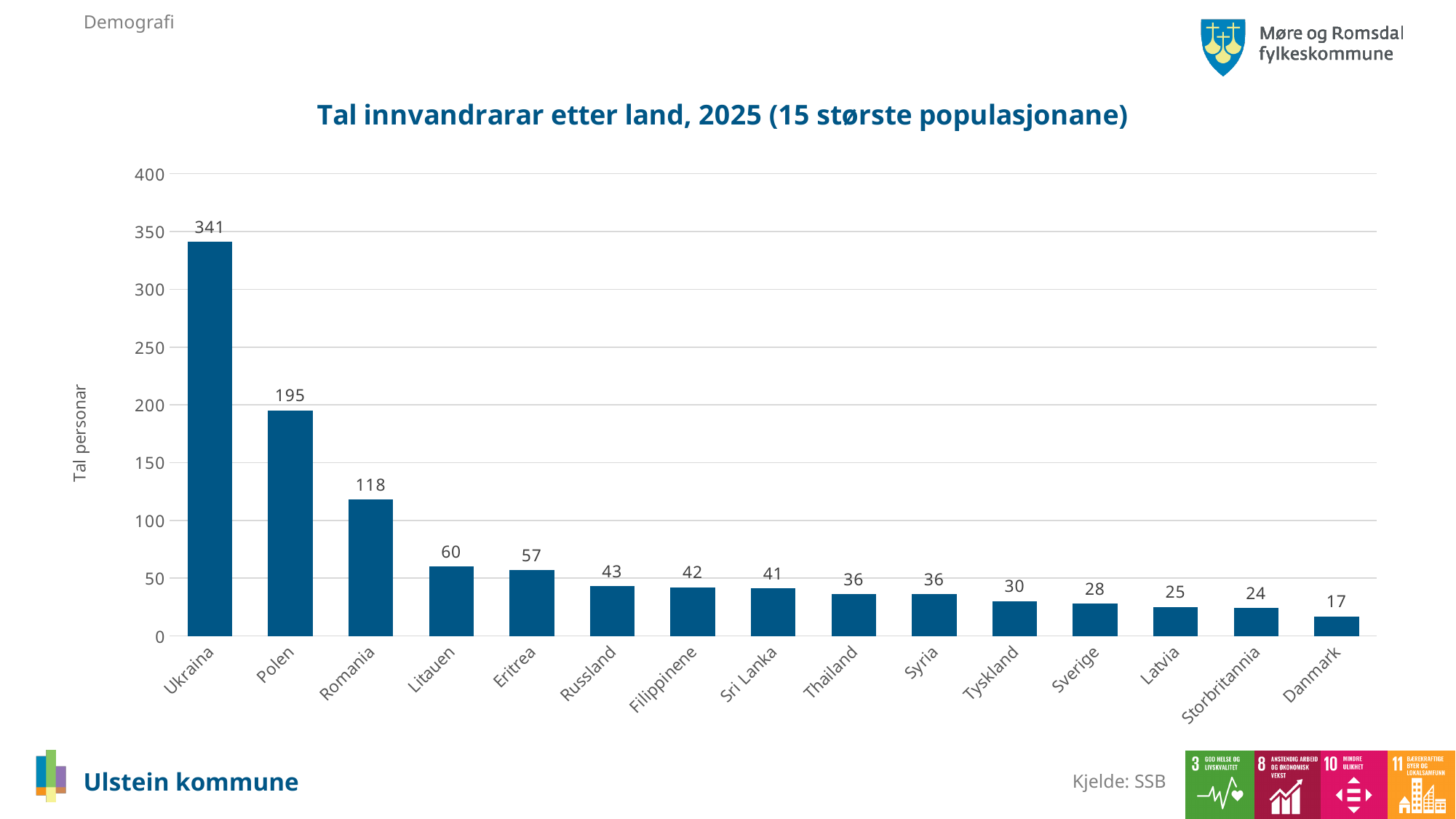
What is the difference between the values for Ukraina and Polen? 146 Which country has the lowest value? Danmark Do the values rise or fall from left to right along the x axis? fall Which country has the highest value? Ukraina What is the value for Ukraina? 341 What is the value for Romania? 118 What is the value for Eritrea? 57 Which has a larger value, Litauen or Russland? Litauen What kind of chart is this? bar chart Is the value for Polen greater or less than 150? greater What is the title of the chart? Tal innvandrarar etter land, 2025 (15 største populasjonane) How many countries are shown in the chart? 15